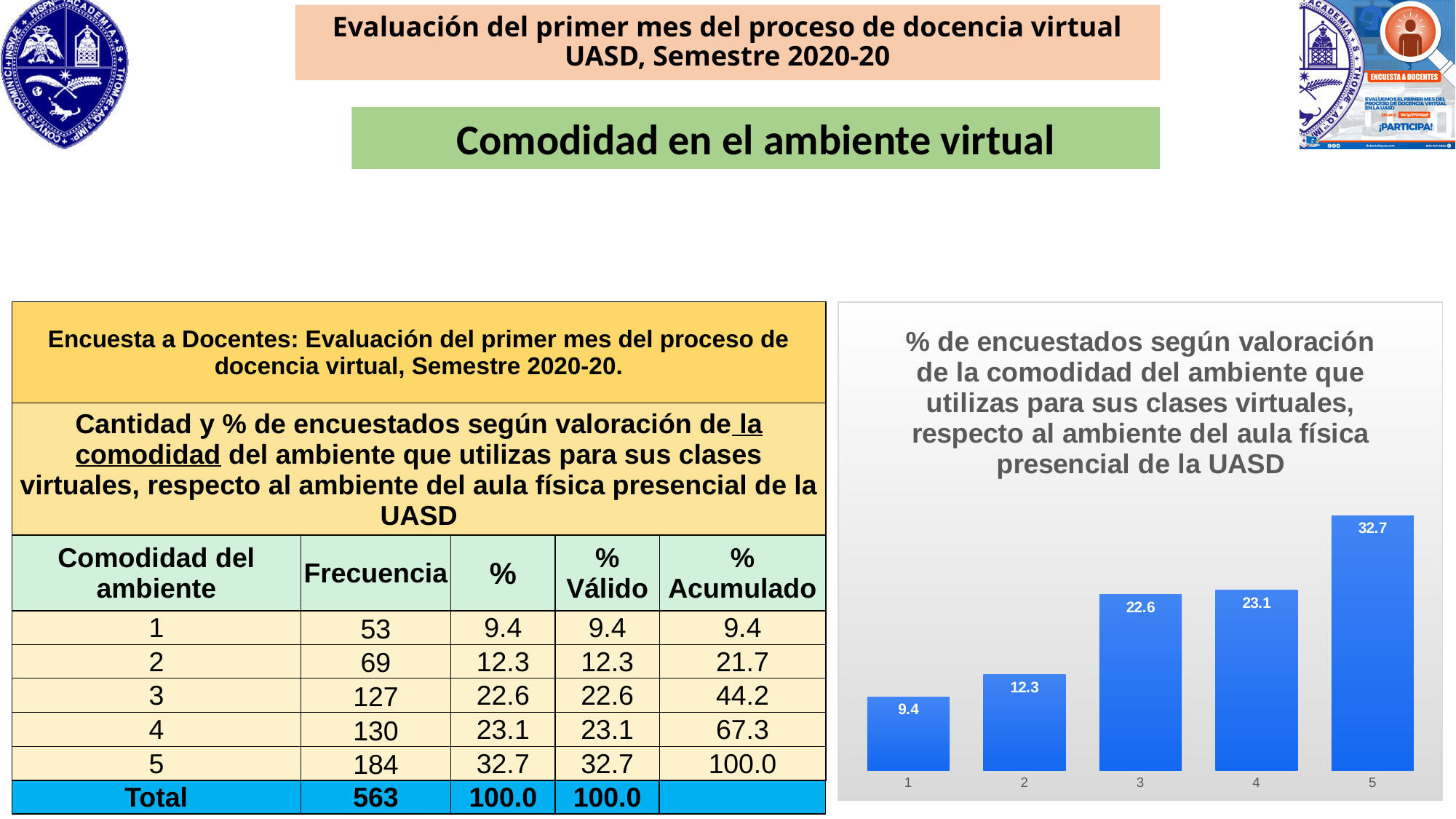
What is the value for category 5 in the chart? 32.7 How many categories are plotted in the chart? 5 What is the difference between the values for category 2 and category 1? 2.9 What type of chart is shown on the slide? bar chart Which category has the lowest value in the chart? 1 What is the value for category 3 in the chart? 22.6 What is the value for category 1 in the chart? 9.4 What colour are the bars in the chart? blue Which category has the highest value in the chart? 5 Do the values rise or fall as you move from category 1 to category 5 along the x axis? rise What is the difference between the values for category 5 and category 4? 9.6 Which is larger, the value for category 4 or the value for category 3? 4